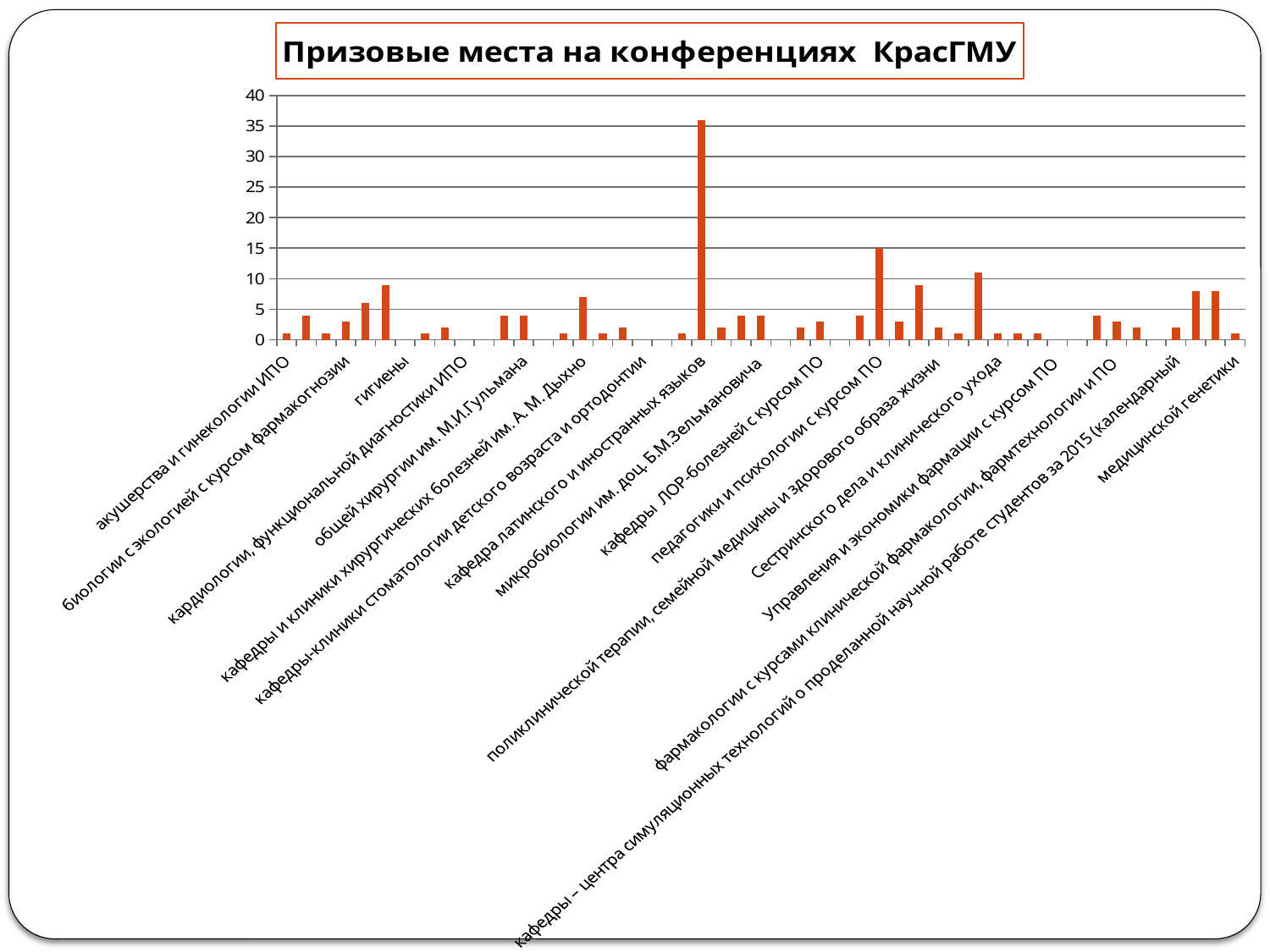
Is the value of the second tallest bar in the chart greater or less than 10? greater Is the value of the tallest bar in the chart greater or less than 30? greater What is the highest value shown on the vertical axis of the chart? 40 How many bars in the chart exceed 20? 1 What kind of chart is shown on the slide? bar chart What is the title of the chart? Призовые места на конференциях КрасГМУ Is the value of the second tallest bar greater or less than 20? less